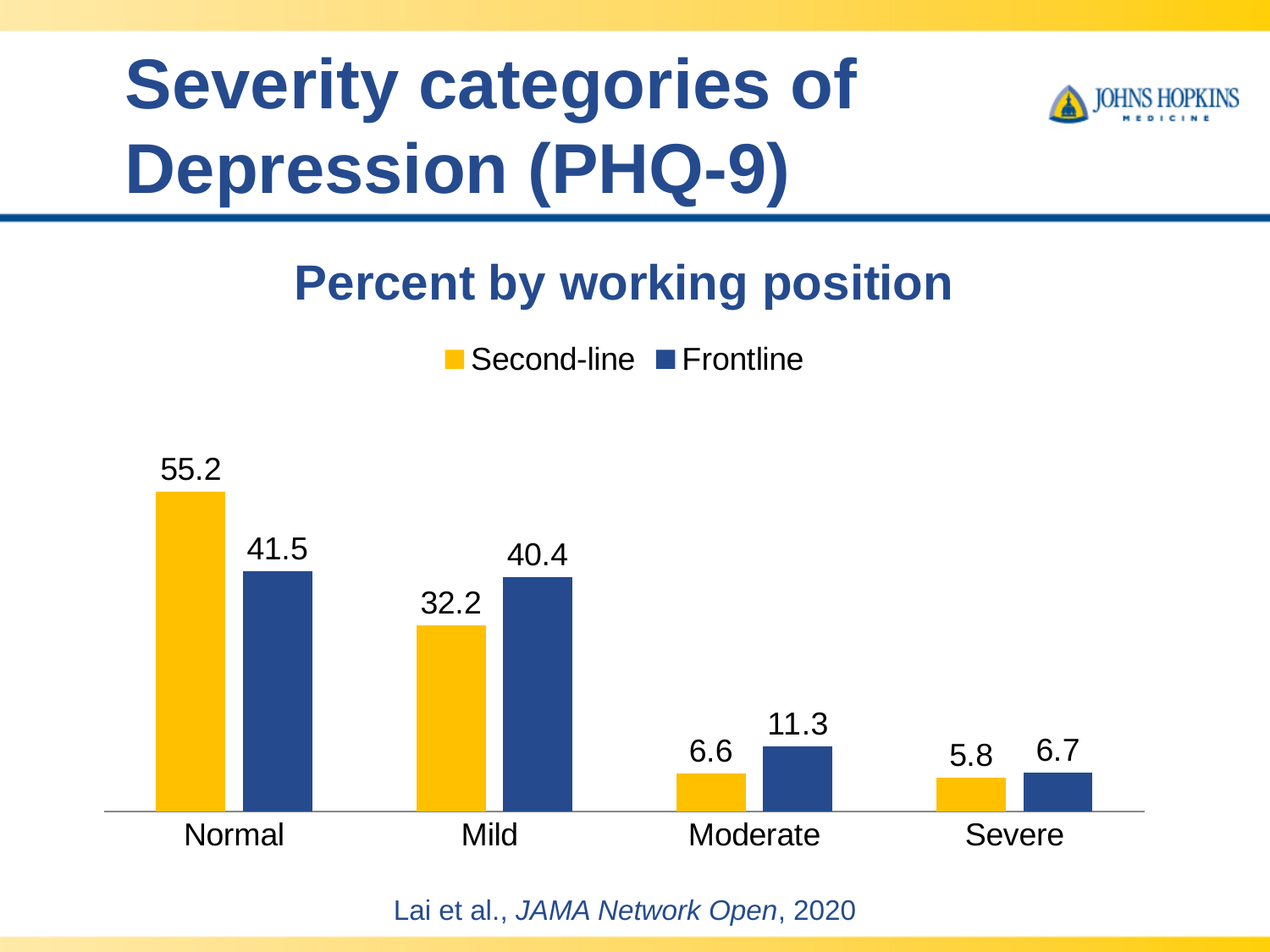
Which category has the lowest Frontline value? Severe What is the difference between the Second-line and Frontline values for the Normal category? 13.7 What is the Second-line value for the Normal category? 55.2 For the Moderate category, which is larger: the Second-line value or the Frontline value? Frontline What type of chart is shown on the slide? Bar chart What is the Frontline value for the Moderate category? 11.3 How many categories are shown on the x axis? 4 What is the Frontline value for the Mild category? 40.4 How many series does the legend list? 2 What is the difference between the Frontline and Second-line values for the Mild category? 8.2 Which category has the highest Second-line value? Normal What is the Second-line value for the Severe category? 5.8